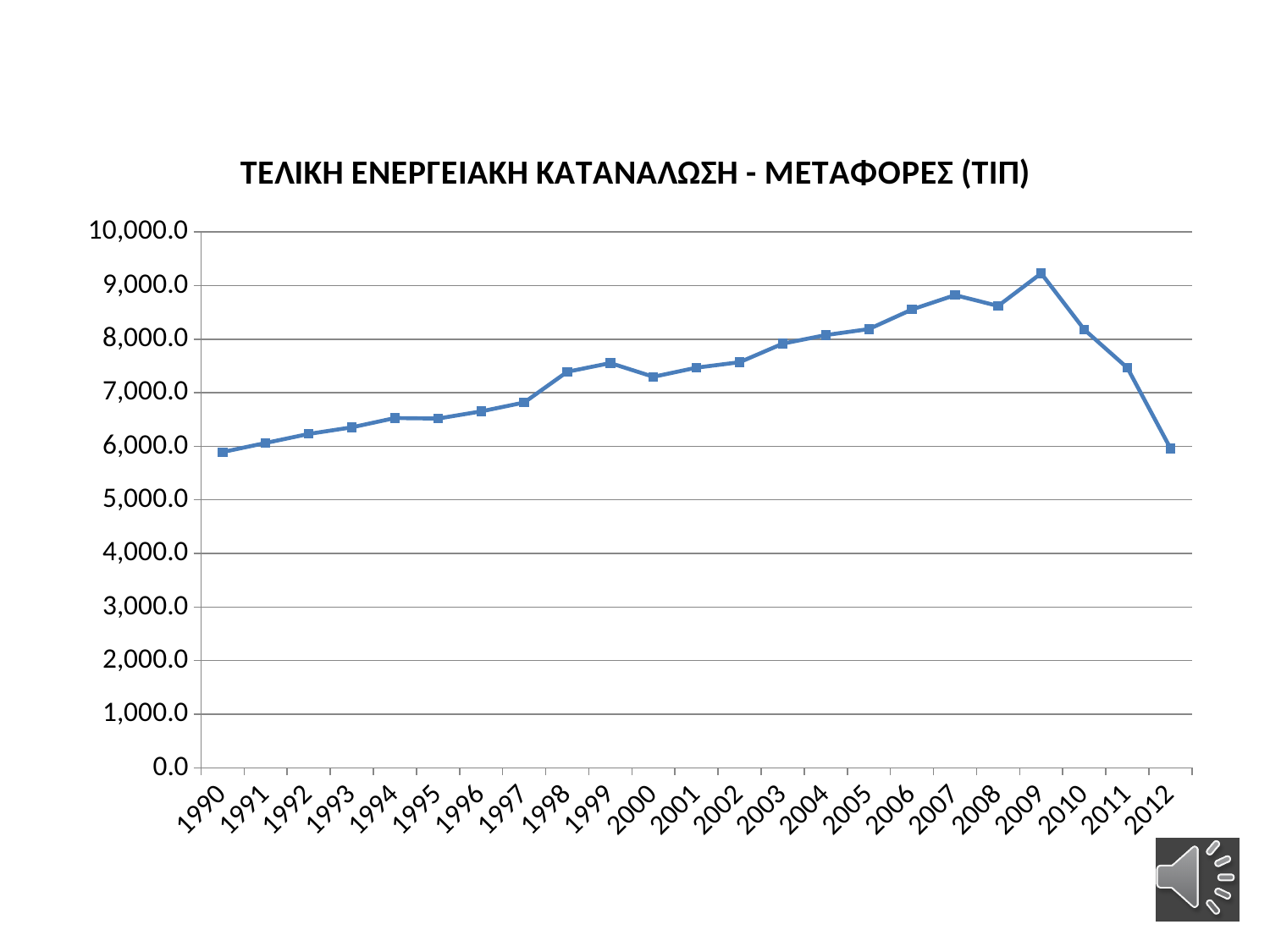
Which year has the larger value, 2007 or 2008? 2007 What kind of chart is shown on the slide? Line chart Is the value for 1995 greater or less than 7,000.0? less Is the value for 2007 greater or less than 8,000.0? greater Is the value for 1990 greater or less than 6,000.0? less Do the values generally rise or fall from 2009 to 2012? fall What is the title of the chart? ΤΕΛΙΚΗ ΕΝΕΡΓΕΙΑΚΗ ΚΑΤΑΝΑΛΩΣΗ - ΜΕΤΑΦΟΡΕΣ (ΤΙΠ) How many years are plotted along the x axis? 23 Which year has the highest value? 2009 Which year has the larger value, 1999 or 2000? 1999